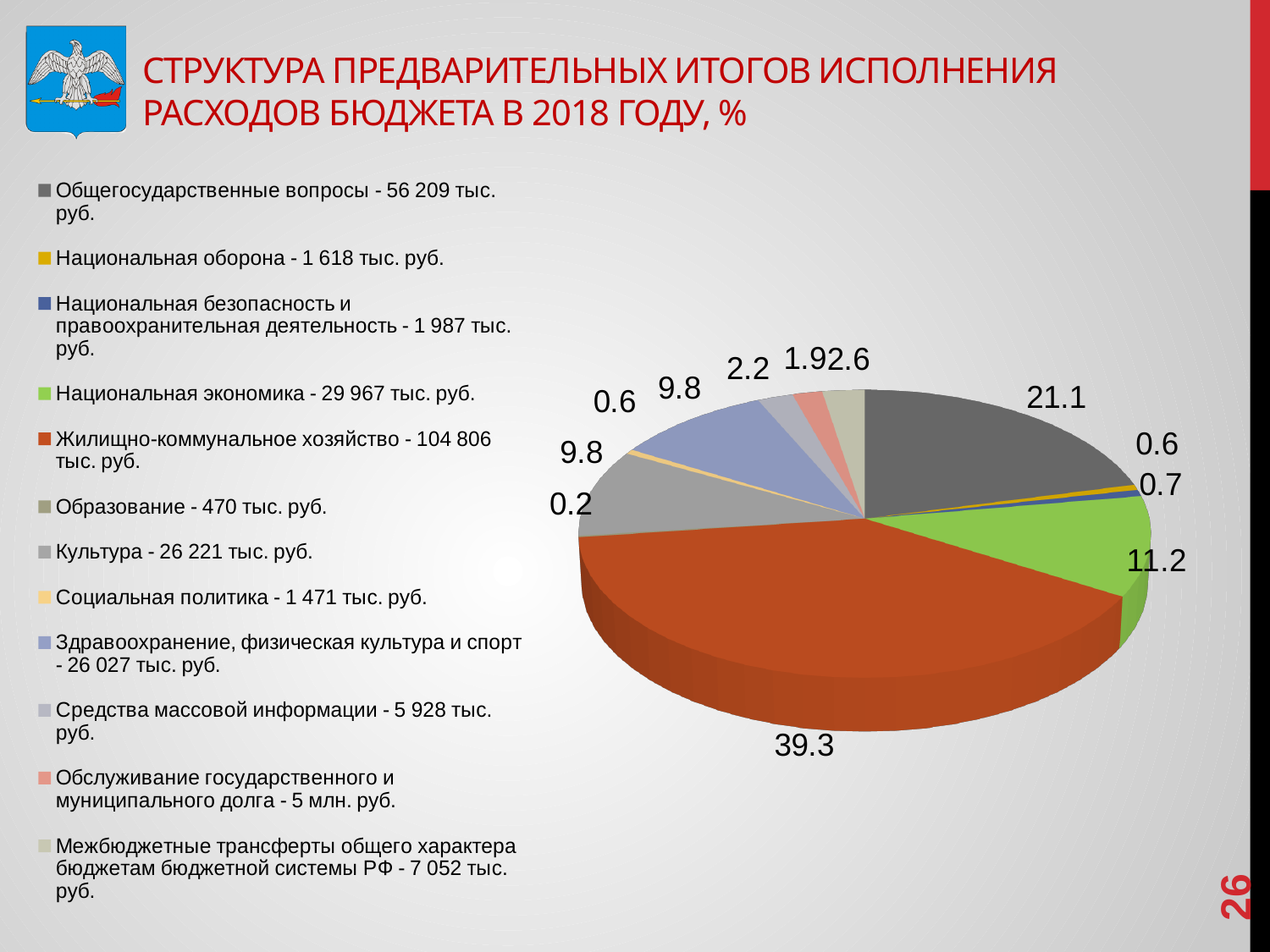
What is the difference in percentage points between the Жилищно-коммунальное хозяйство slice and the Общегосударственные вопросы slice? 18.2 What is the title of the slide containing the pie chart? Структура предварительных итогов исполнения расходов бюджета в 2018 году, % Which category has the smallest slice of the pie chart? Образование What is the difference in percentage points between the Общегосударственные вопросы slice and the Национальная экономика slice? 9.9 Which slice is larger: Национальная экономика or Культура? Национальная экономика How many categories are listed in the legend of the pie chart? 12 What percentage share does Общегосударственные вопросы have in the pie chart? 21.1 What percentage share does Национальная экономика have in the pie chart? 11.2 Which category has the largest slice of the pie chart? Жилищно-коммунальное хозяйство What percentage share does Жилищно-коммунальное хозяйство have in the pie chart? 39.3 What percentage share does Образование have in the pie chart? 0.2 What type of chart is shown on the slide? Pie chart